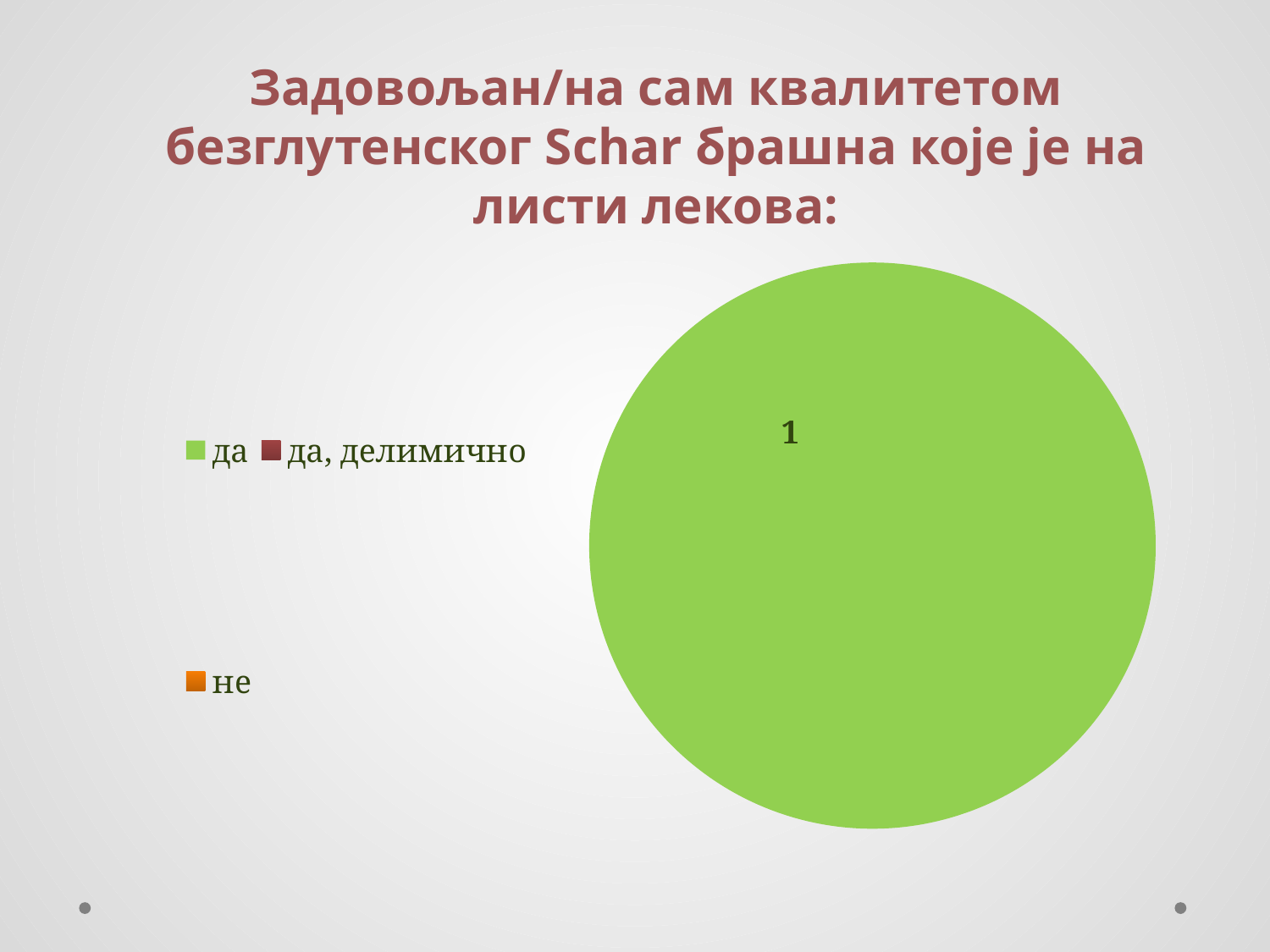
What colour is the "да" entry in the legend? green How many slices are visible in the pie chart? 1 What value is printed on the pie chart slice? 1 Which category does the only visible slice of the pie chart represent? да Which legend entry is shown in orange? не What kind of chart is shown on the slide? pie chart How many entries does the legend of the pie chart list? 3 What share of the pie does the "да" slice take up? 100%